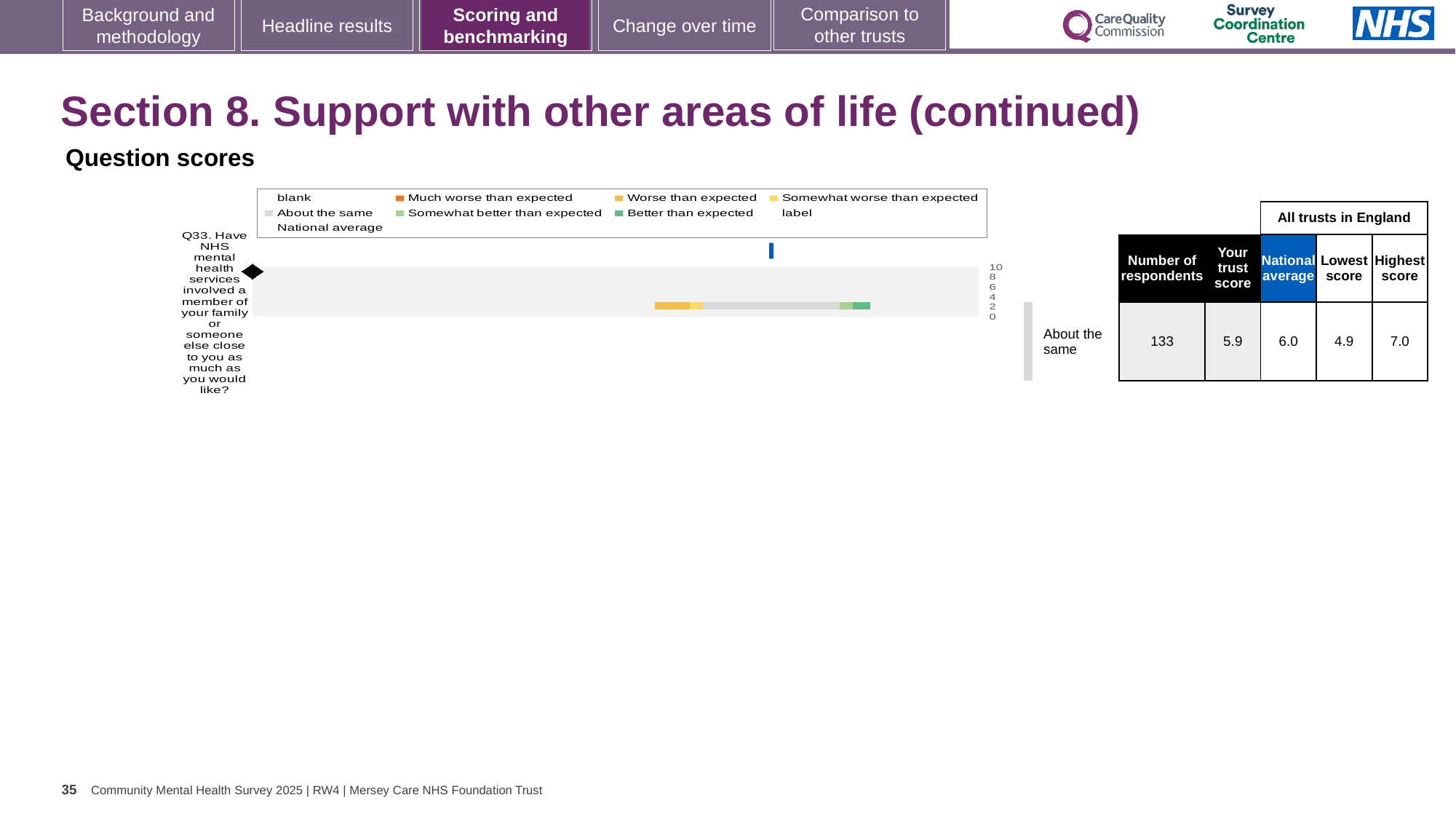
For Q33, what is the difference between the Highest score and the Lowest score among all trusts in England? 2.1 In the table beside the chart, what is the Highest score among all trusts in England for Q33? 7.0 What kind of chart is used to show the Q33 question score? bar chart How many questions are plotted in the question scores chart? 1 In the table beside the chart, what is the National average score for Q33? 6.0 In the table beside the chart, what is the Lowest score among all trusts in England for Q33? 4.9 In the table beside the chart, what is the Number of respondents for Q33? 133 How many entries does the legend of the question scores chart list? 9 For Q33, which is larger: the trust score or the National average? National average In the table beside the chart, what is the 'Your trust score' for Q33? 5.9 Which question number is plotted in the question scores chart? Q33